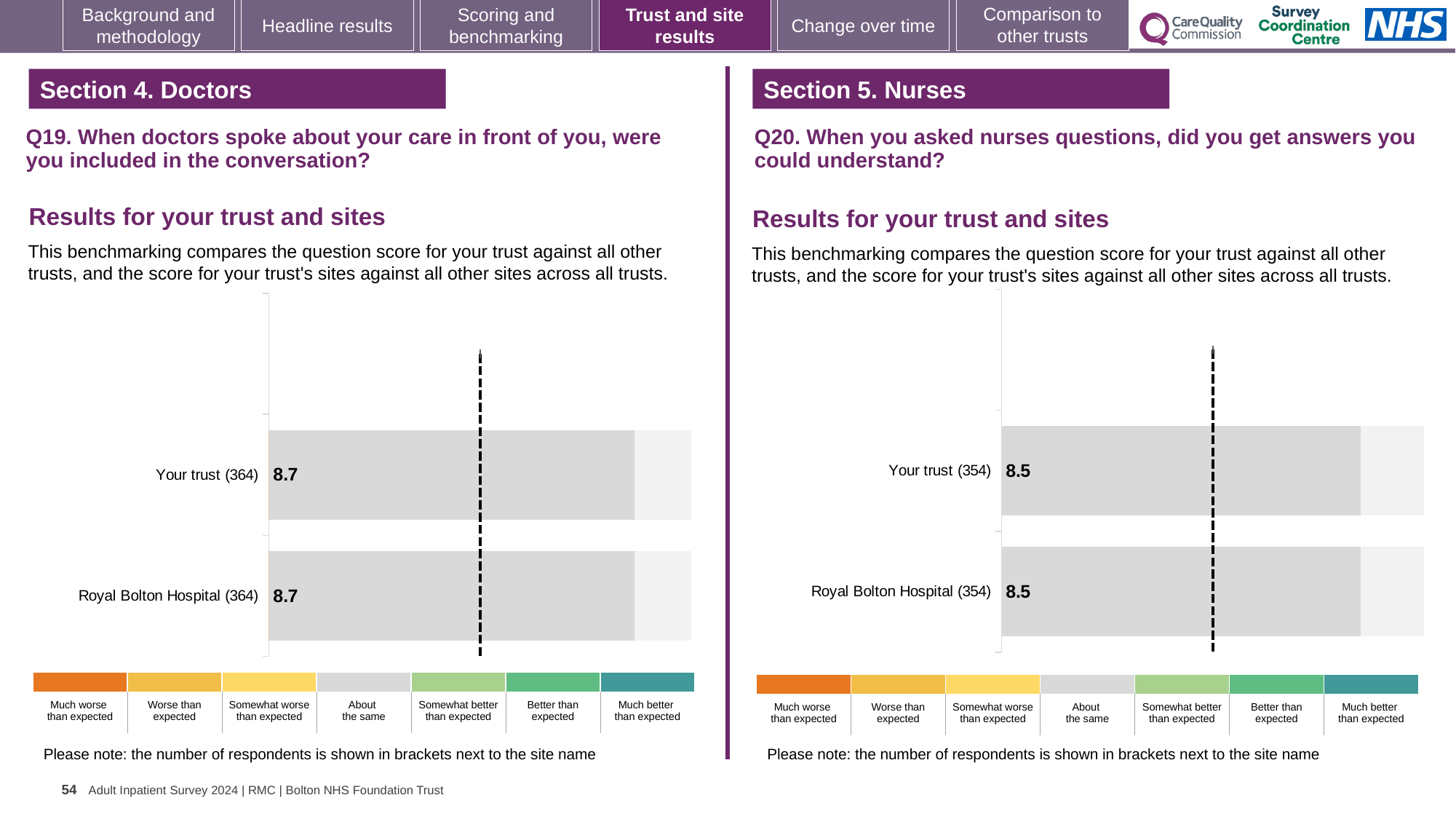
In the Q20 chart on the right, how many respondents are shown in brackets next to Royal Bolton Hospital? 354 In the Q19 chart on the left, how many respondents are shown in brackets next to Your trust? 364 In the Q19 chart on the left, what is the score for Royal Bolton Hospital? 8.7 In the Q20 chart on the right, what is the score for Royal Bolton Hospital? 8.5 In the Q19 chart on the left, what is the score for Your trust? 8.7 How many bars are plotted in the Q19 chart on the left? 2 Which is larger: the Your trust score in the Q19 chart on the left or the Your trust score in the Q20 chart on the right? Q19 chart on the left How many categories does the colour key below the Q20 chart on the right list? 7 In the Q20 chart on the right, what is the score for Your trust? 8.5 What is the difference between the Your trust score in the Q19 chart on the left and the Your trust score in the Q20 chart on the right? 0.2 What kind of chart is used for the Q19 results on the left? Bar chart How many bars are plotted in the Q20 chart on the right? 2